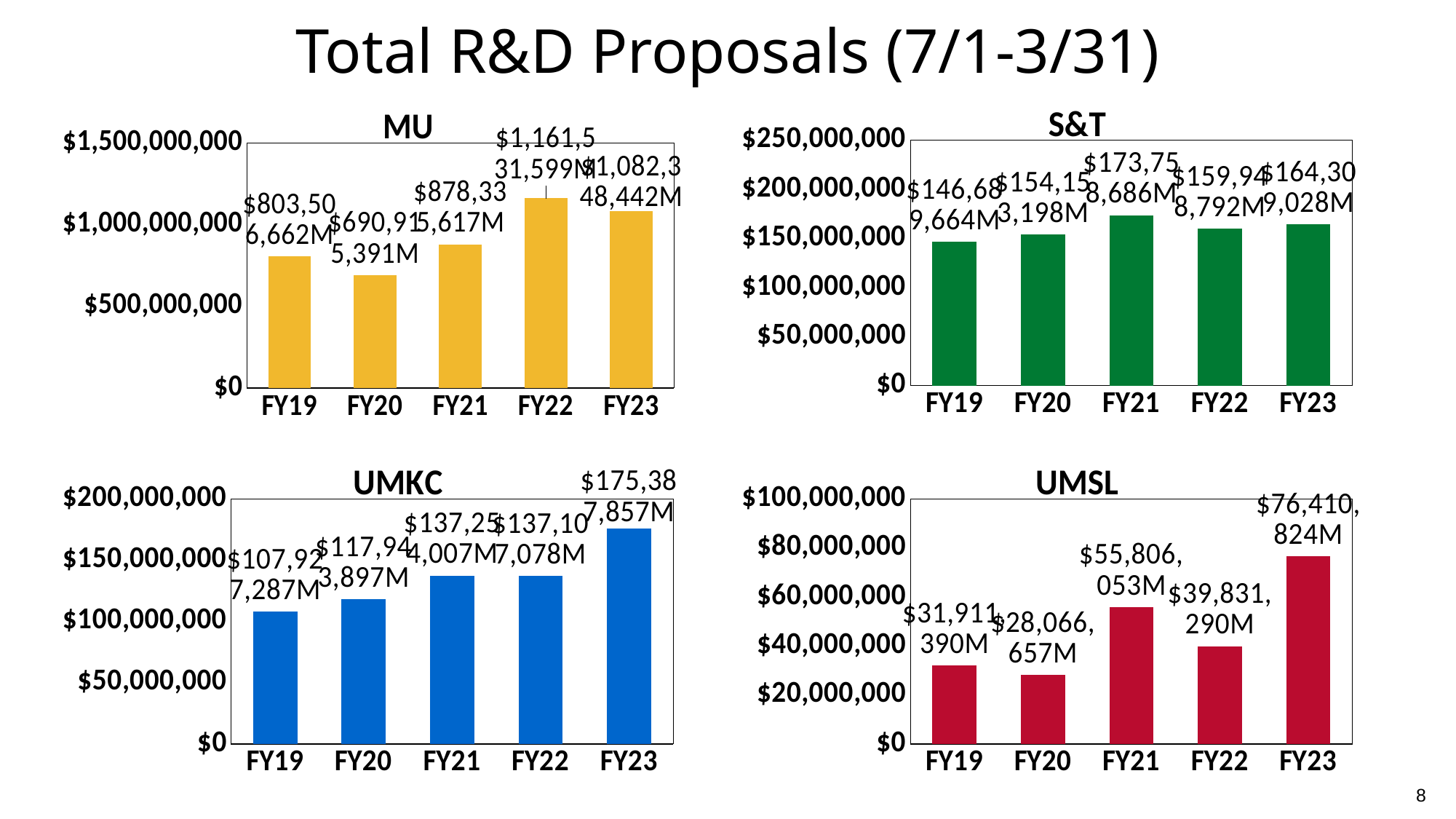
On the S&T chart, which fiscal year has the lowest value? FY19 On the S&T chart, what is the value for FY21? $173,758,686M On the MU chart, is the value for FY22 greater or less than $1,000,000,000? greater On the UMSL chart, what is the value for FY21? $55,806,053M What kind of chart is the S&T chart? bar chart On the UMSL chart, which fiscal year has the lowest value? FY20 On the MU chart, which fiscal year has the highest value? FY22 On the UMSL chart, which is larger, the value for FY21 or the value for FY22? FY21 On the UMKC chart, what is the value for FY23? $175,387,857M On the MU chart, which fiscal year has the lowest value? FY20 On the UMSL chart, what is the value for FY23? $76,410,824M How many fiscal years are shown on the UMKC chart? 5